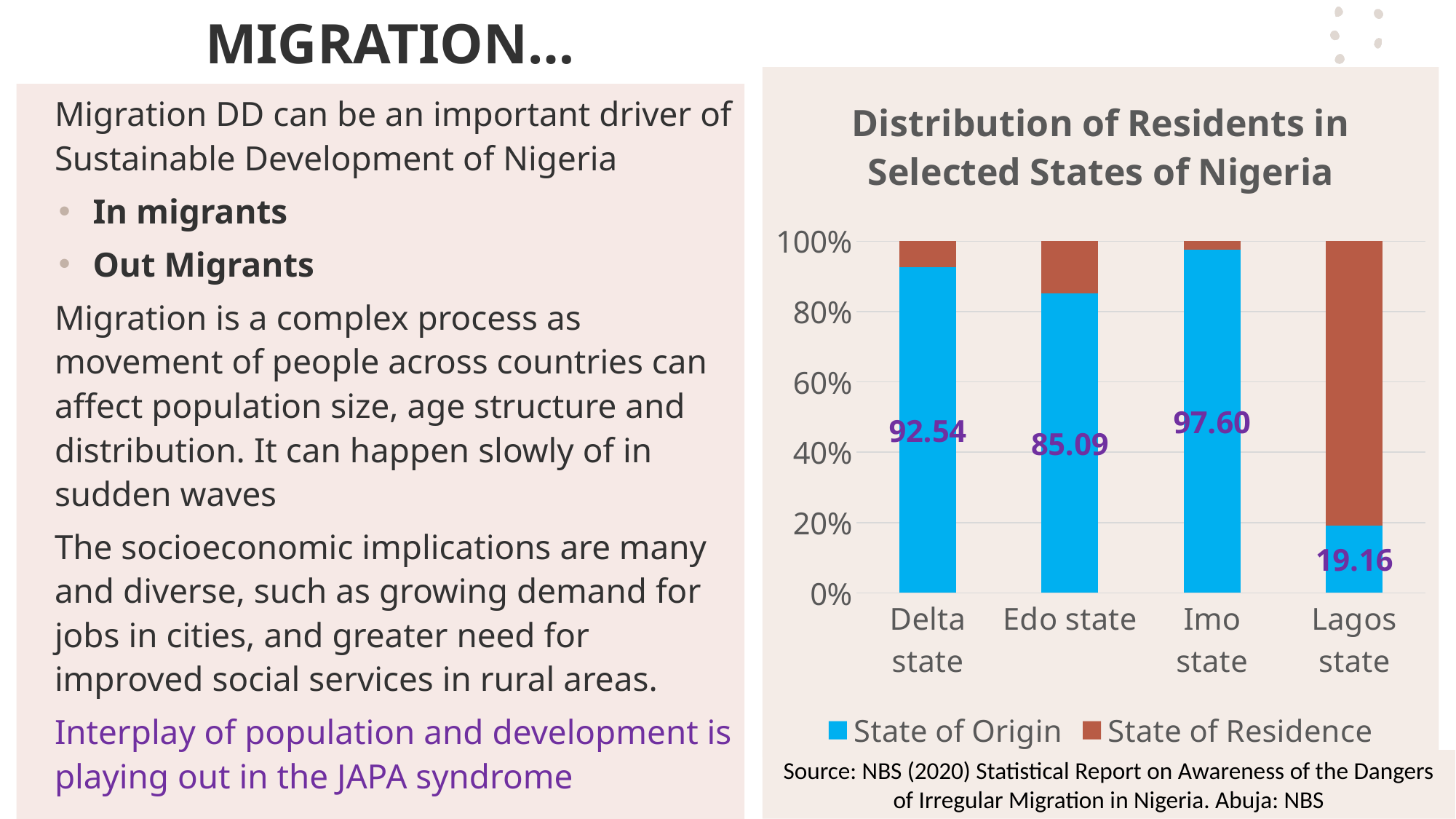
What is the difference between the State of Origin values for Delta state and Lagos state? 73.38 What is the State of Origin value for Edo state? 85.09 Which has a larger State of Origin value, Edo state or Delta state? Delta state What is the difference between the State of Origin values for Imo state and Delta state? 5.06 How many states are shown on the x axis of the chart? 4 What type of chart is shown on the slide? Stacked bar chart Which state has the highest State of Origin value? Imo state Is the State of Residence share for Lagos state greater or less than 60%? greater Which state has the lowest State of Origin value? Lagos state How many series does the chart legend list? 2 What is the State of Origin value for Lagos state? 19.16 What is the State of Origin value for Delta state? 92.54